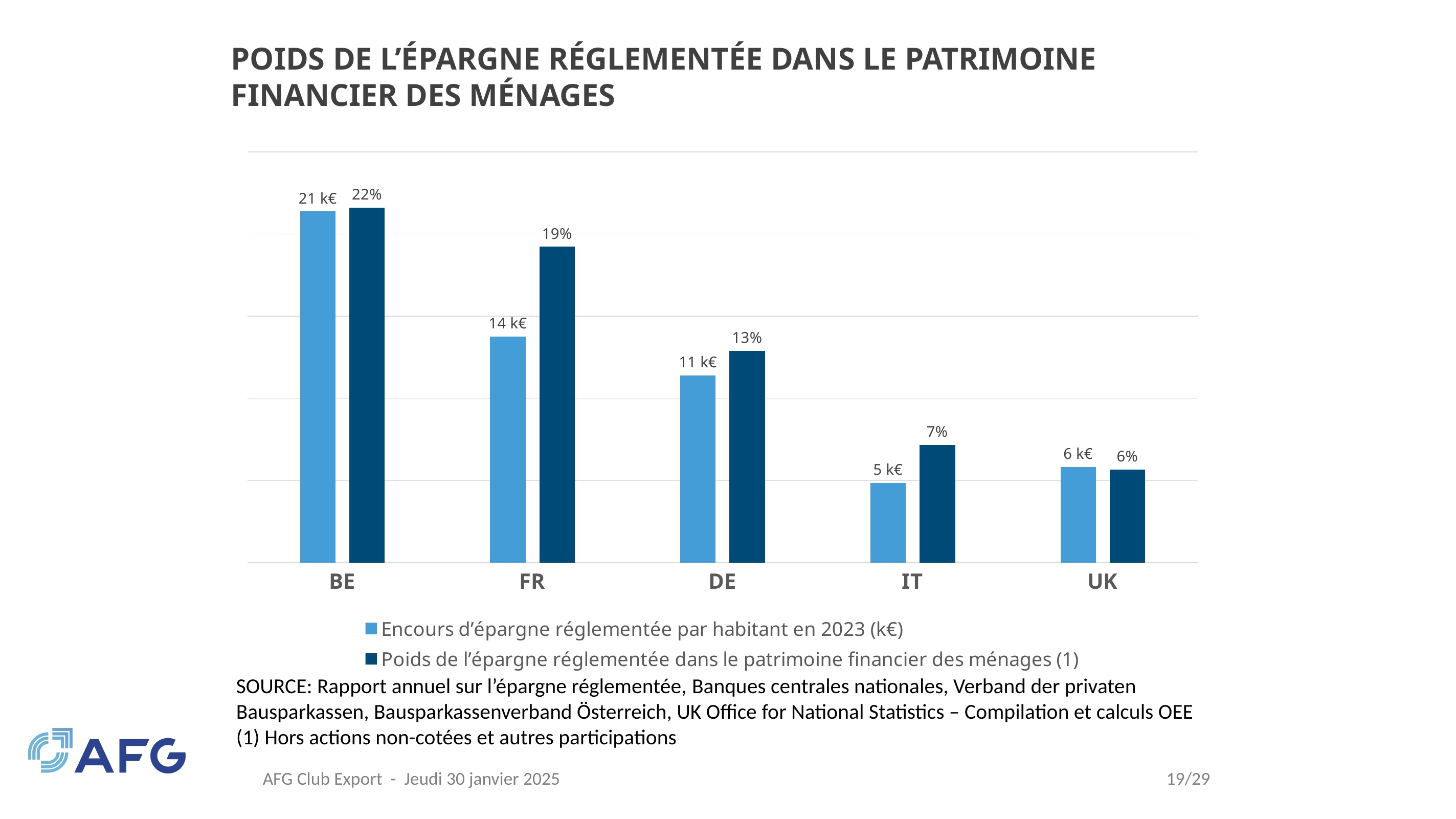
What is the value of 'Encours d'épargne réglementée par habitant en 2023 (k€)' for DE? 11 k€ Which is larger: the 'Poids de l'épargne réglementée dans le patrimoine financier des ménages (1)' value for IT or for UK? IT What is the difference between the 'Poids de l'épargne réglementée dans le patrimoine financier des ménages (1)' values for FR and DE? 6% What is the value of 'Encours d'épargne réglementée par habitant en 2023 (k€)' for BE? 21 k€ What is the difference between the 'Encours d'épargne réglementée par habitant en 2023 (k€)' values for BE and FR? 7 k€ Which country has the highest value for 'Poids de l'épargne réglementée dans le patrimoine financier des ménages (1)'? BE What is the value of 'Poids de l'épargne réglementée dans le patrimoine financier des ménages (1)' for UK? 6% How many series does the legend list? 2 What is the value of 'Poids de l'épargne réglementée dans le patrimoine financier des ménages (1)' for FR? 19% Which country has the lowest value for 'Encours d'épargne réglementée par habitant en 2023 (k€)'? IT What kind of chart is shown on the slide? Bar chart How many countries are shown on the x axis of the chart? 5